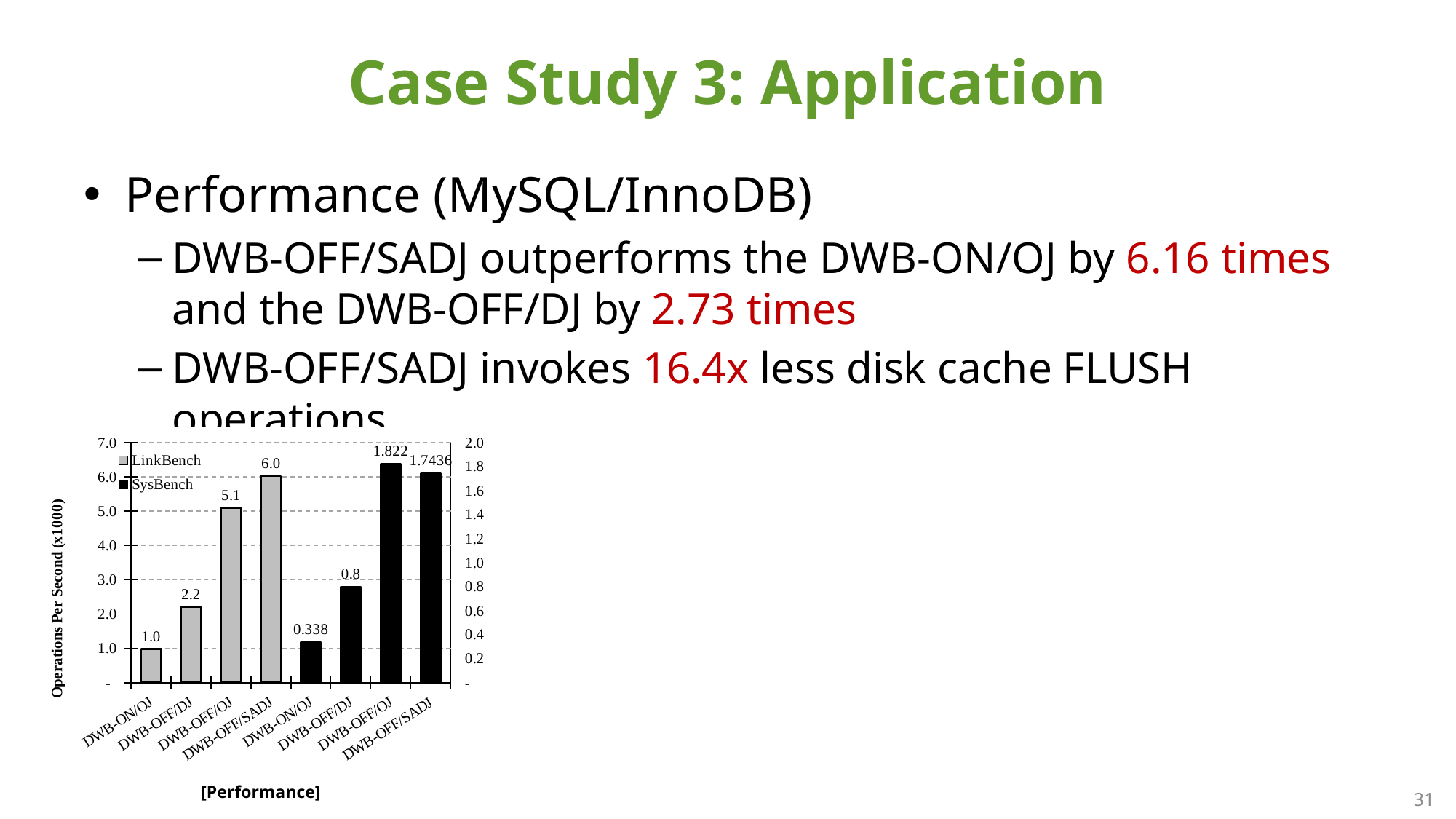
What is the SysBench value for DWB-ON/OJ? 0.338 Which configuration has the lowest SysBench value? DWB-ON/OJ What type of chart is shown on the slide? bar chart How many bars are plotted in the chart in total? 8 What is the SysBench value for DWB-OFF/OJ? 1.822 What is the difference between the LinkBench values for DWB-OFF/SADJ and DWB-ON/OJ? 5.0 Which configuration has the highest LinkBench value? DWB-OFF/SADJ What is the LinkBench value for DWB-OFF/DJ? 2.2 How many series does the chart legend list? 2 What is the LinkBench value for DWB-OFF/SADJ? 6.0 Which is larger for LinkBench: DWB-OFF/OJ or DWB-OFF/DJ? DWB-OFF/OJ What is the SysBench value for DWB-OFF/SADJ? 1.7436